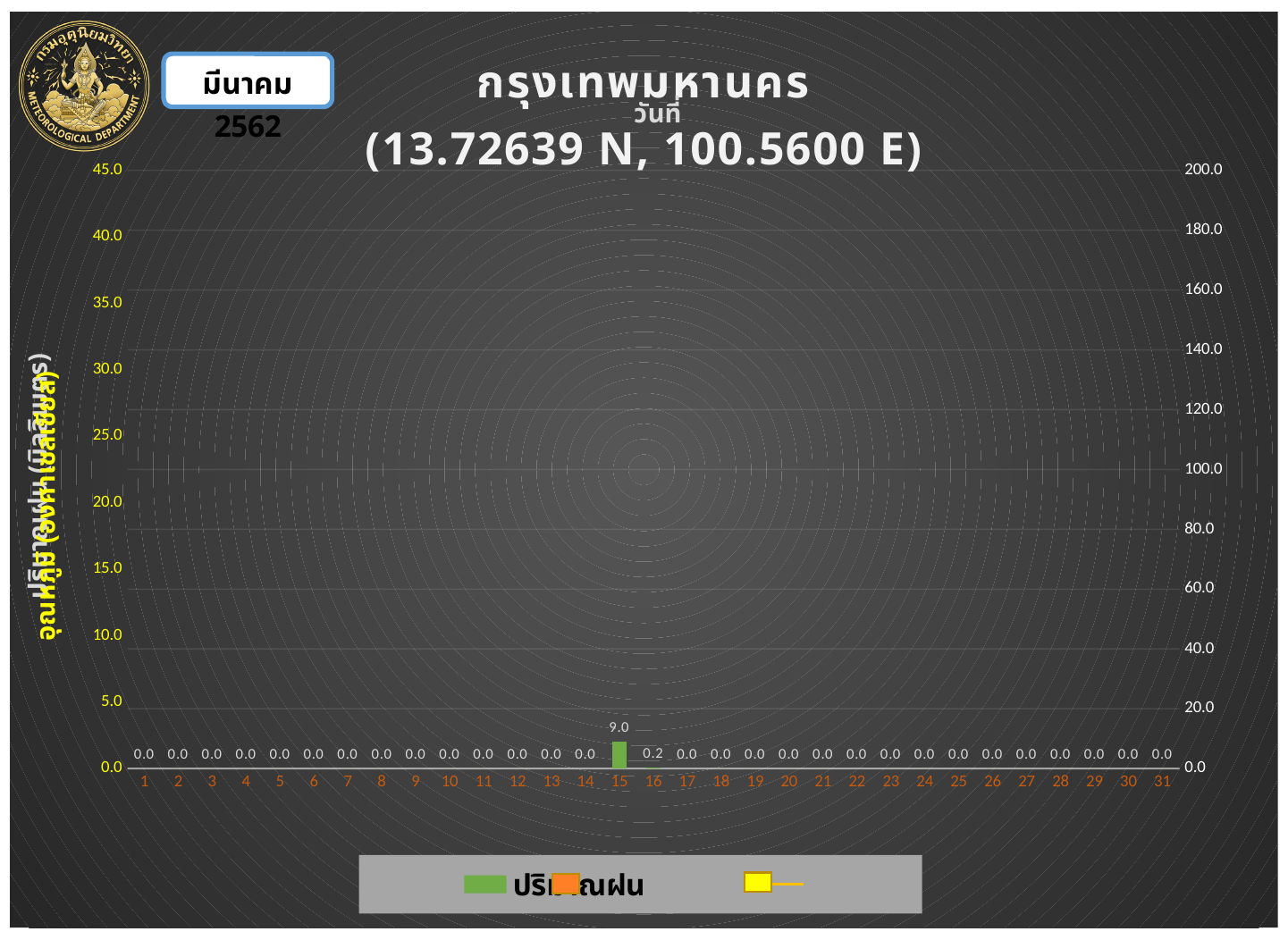
What is the rainfall value shown for day 1? 0.0 What is the difference between the rainfall values for day 15 and day 16? 8.8 Which day has the highest rainfall value? 15 What is the rainfall value shown for day 16? 0.2 What is the rainfall value shown for day 31? 0.0 Which has the larger rainfall value, day 15 or day 16? day 15 What is the rainfall value shown for day 15? 9.0 What colour is the bar for ปริมาณฝน in the legend? green How many days are shown on the x axis? 31 Is the rainfall value for day 15 greater or less than 10.0 on the left axis? less What kind of chart is shown on the slide? bar chart What is the highest value shown on the right-hand axis? 200.0